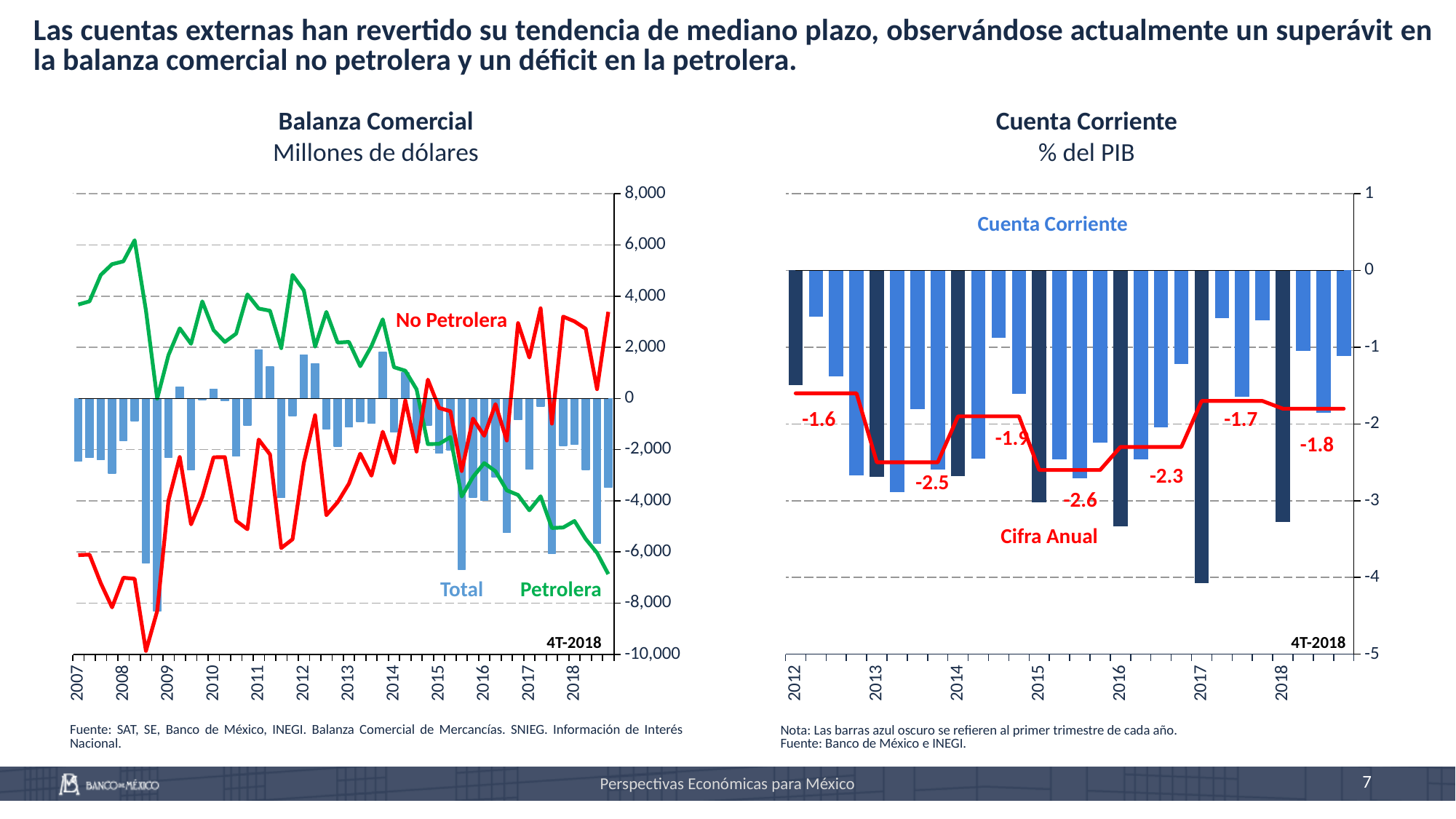
In the Balanza Comercial chart, does the Petrolera line rise or fall between 2014 and 2018? fall What kind of chart is the Balanza Comercial chart? Bar chart with line series According to the note under the Cuenta Corriente chart, what do the dark blue bars refer to? The first quarter of each year In the Cuenta Corriente chart, what is the difference between the annual figures for 2012 (-1.6) and 2015 (-2.6)? 1.0 In the Balanza Comercial chart, how many series are shown (bars and lines combined)? 3 In the Cuenta Corriente chart, which year has the highest (least negative) annual figure on the Cifra Anual line? 2012 In the Cuenta Corriente chart, what is the annual figure (Cifra Anual) shown for 2013? -2.5 In the Cuenta Corriente chart, which year has the lowest (most negative) annual figure on the Cifra Anual line? 2015 In the Cuenta Corriente chart, what is the annual figure (Cifra Anual) shown for 2018? -1.8 In the Cuenta Corriente chart, which annual figure is higher (less negative): 2016 or 2017? 2017 In the Balanza Comercial chart, is the lowest point of the No Petrolera line greater or less than -8,000? less In the Cuenta Corriente chart, is the dark blue bar for the first quarter of 2017 greater or less than -3? less